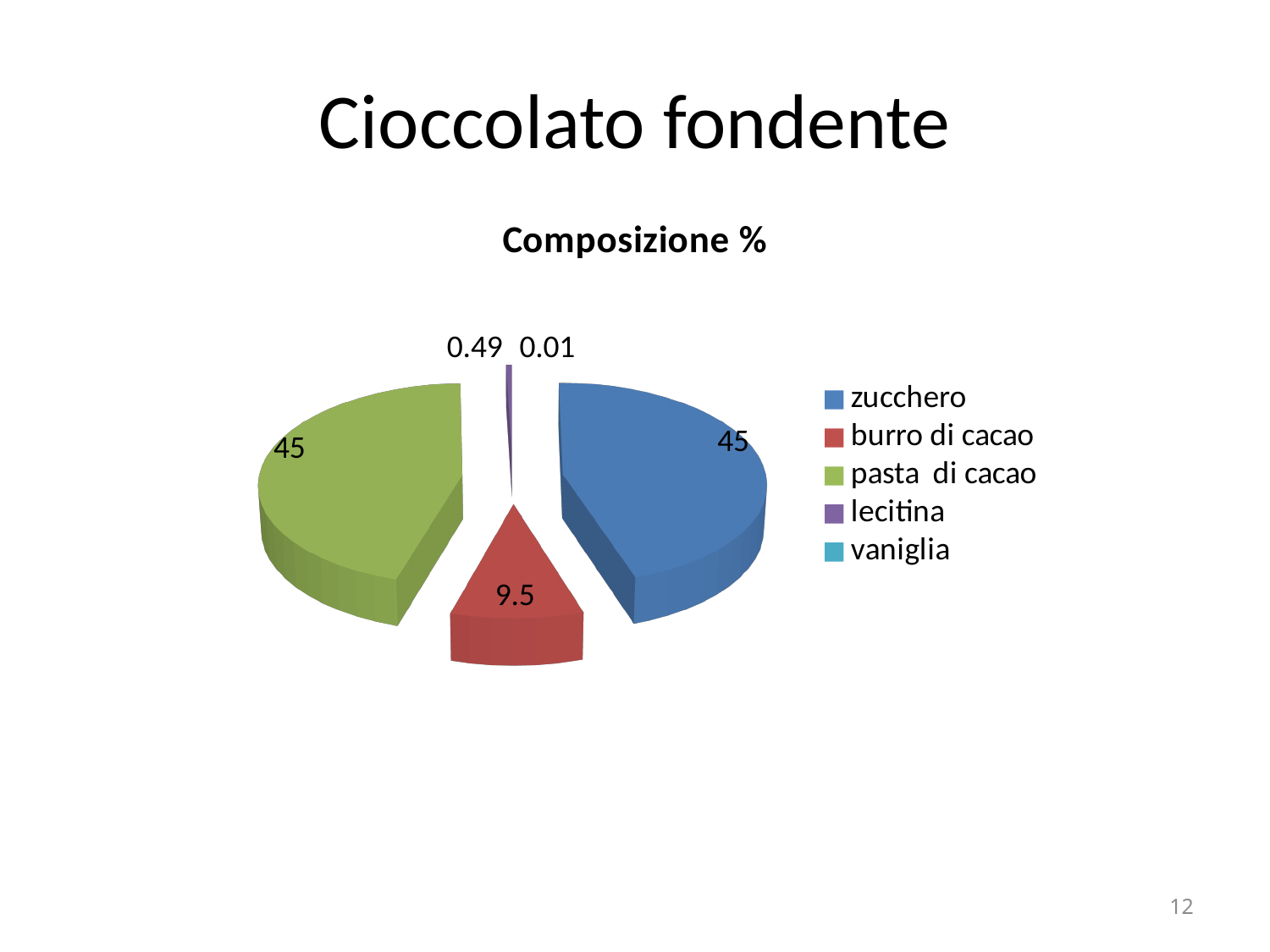
What is the value for burro di cacao in the Composizione % pie chart? 9.5 Which is larger in the Composizione % pie chart, zucchero or burro di cacao? zucchero What is the value for zucchero in the Composizione % pie chart? 45 What is the difference between the values for zucchero and burro di cacao in the Composizione % pie chart? 35.5 Which category has the smallest value in the Composizione % pie chart? vaniglia What is the value for pasta di cacao in the Composizione % pie chart? 45 How many categories are shown in the Composizione % pie chart? 5 What is the value for lecitina in the Composizione % pie chart? 0.49 What is the value for vaniglia in the Composizione % pie chart? 0.01 What is the title of the chart on the slide? Composizione % What colour represents pasta di cacao in the Composizione % pie chart? green What kind of chart is shown on the slide? pie chart